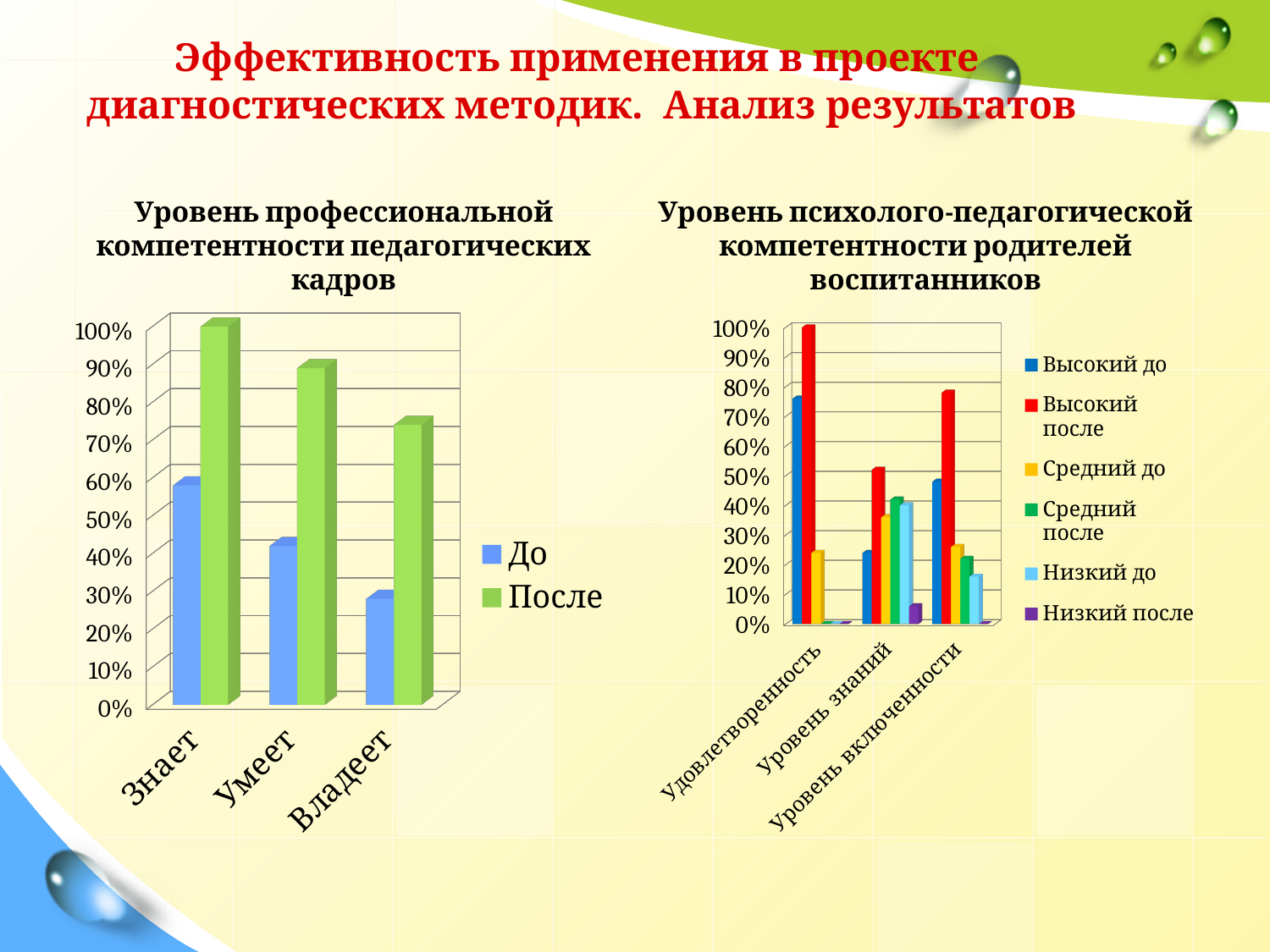
In the left chart ("Уровень профессиональной компетентности педагогических кадров"), is the value for "Владеет" in the "До" series greater or less than 40%? less In the left chart ("Уровень профессиональной компетентности педагогических кадров"), which category has the highest value in the "После" series? Знает In the left chart ("Уровень профессиональной компетентности педагогических кадров"), do the values of the "До" series rise or fall from "Знает" to "Владеет"? fall In the left chart ("Уровень профессиональной компетентности педагогических кадров"), which is larger for "Умеет": the "До" value or the "После" value? После In the right chart ("Уровень психолого-педагогической компетентности родителей воспитанников"), which category has the highest value in the "Высокий до" series? Удовлетворенность How many series does the legend of the left chart ("Уровень профессиональной компетентности педагогических кадров") list? 2 How many series does the legend of the right chart ("Уровень психолого-педагогической компетентности родителей воспитанников") list? 6 In the right chart ("Уровень психолого-педагогической компетентности родителей воспитанников"), what colour represents the "Низкий после" series? purple In the right chart ("Уровень психолого-педагогической компетентности родителей воспитанников"), is the value for "Удовлетворенность" in the "Высокий после" series greater or less than 90%? greater What kind of chart is the left chart titled "Уровень профессиональной компетентности педагогических кадров"? bar chart In the left chart ("Уровень профессиональной компетентности педагогических кадров"), is the value for "Знает" in the "До" series greater or less than 50%? greater How many categories are shown on the x axis of the left chart ("Уровень профессиональной компетентности педагогических кадров")? 3